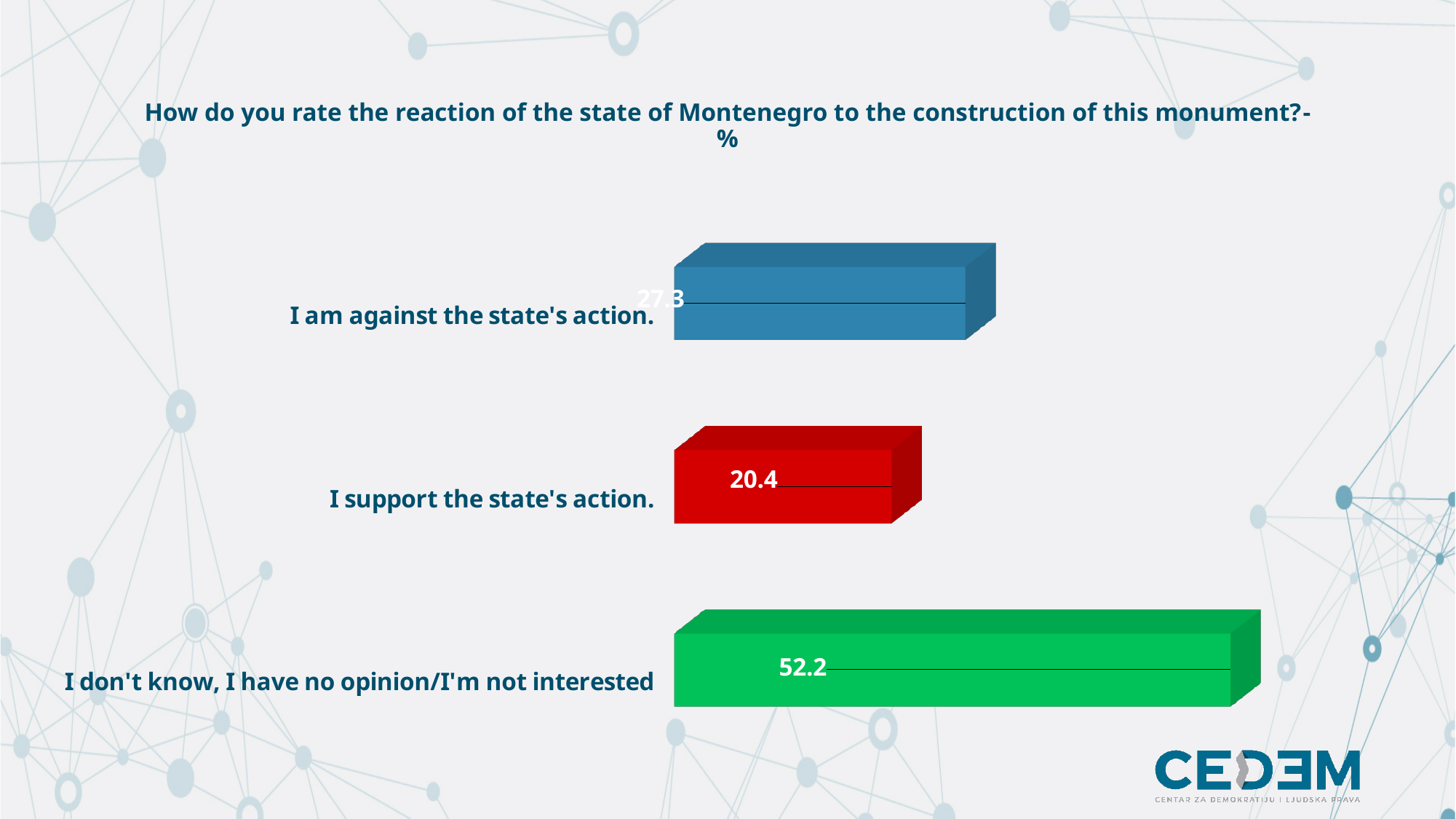
What is the difference between the values for "I am against the state's action." and "I support the state's action."? 6.9 What is the title of the chart? How do you rate the reaction of the state of Montenegro to the construction of this monument?-% What kind of chart is shown on the slide? Bar chart Which is larger: the value for "I am against the state's action." or "I support the state's action."? I am against the state's action. How many categories are shown in the chart? 3 What is the value for "I don't know, I have no opinion/I'm not interested"? 52.2 Which category has the lowest value? I support the state's action. What is the difference between the values for "I don't know, I have no opinion/I'm not interested" and "I am against the state's action."? 24.9 What is the value for "I am against the state's action."? 27.3 Which category has the highest value? I don't know, I have no opinion/I'm not interested What colour is the bar for "I support the state's action."? Red What is the value for "I support the state's action."? 20.4